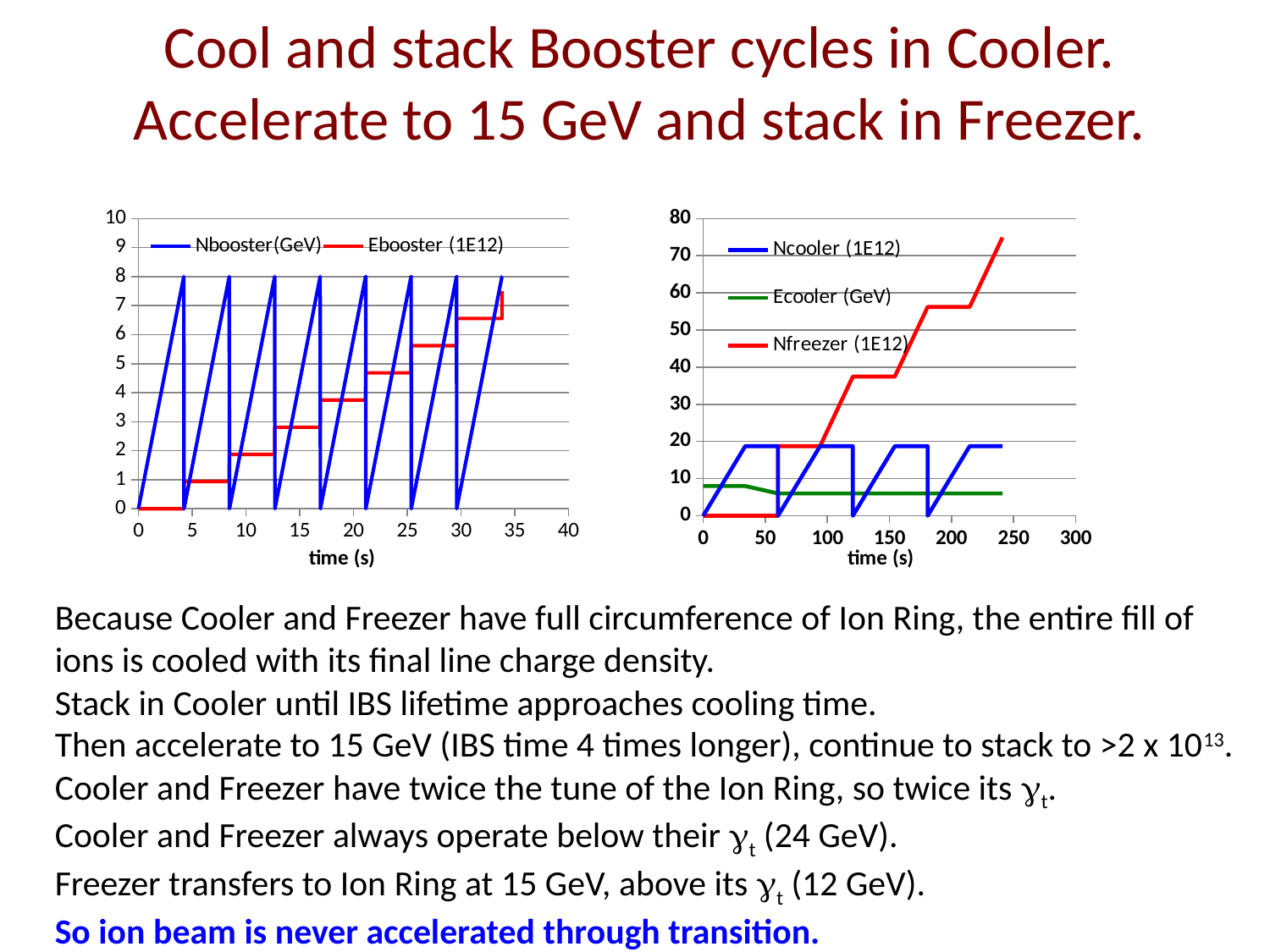
In the left chart, is the value of Ebooster (1E12) at time 10 s greater or less than 3? less How many series does the legend of the left chart list? 2 In the right chart, is the value of Nfreezer (1E12) at time 150 s greater or less than 30? greater What is the x-axis title of the left chart? time (s) In the right chart, is the value of Ecooler (GeV) at time 200 s greater or less than 10? less In the right chart, does Nfreezer (1E12) generally rise or fall as time increases? rise In the right chart, which series is drawn in green? Ecooler (GeV) In the left chart, does Ebooster (1E12) generally rise or fall as time increases? rise What kind of chart is the left chart on the slide? line chart How many series does the legend of the right chart list? 3